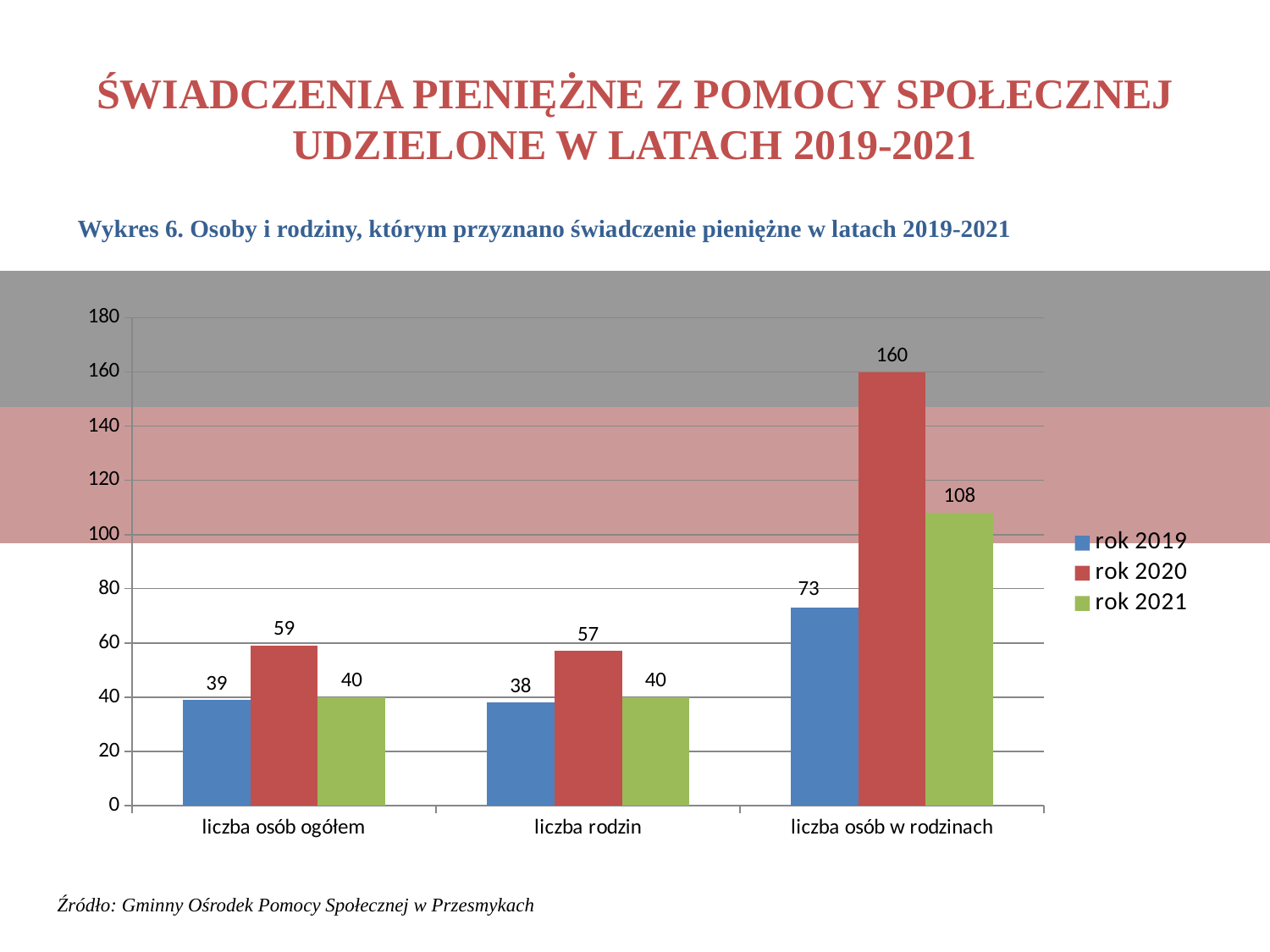
What is the value for 'rok 2020' in the 'liczba osób w rodzinach' category? 160 Which series has the highest value in the 'liczba osób w rodzinach' category? rok 2020 How many series does the legend list? 3 What is the value for 'rok 2019' in the 'liczba osób ogółem' category? 39 What is the value for 'rok 2021' in the 'liczba rodzin' category? 40 What kind of chart is shown on the slide? bar chart Which colour represents 'rok 2021' in the legend? green Which is larger: the 'rok 2020' value for 'liczba osób ogółem' or the 'rok 2020' value for 'liczba rodzin'? liczba osób ogółem What is the difference between the 'rok 2020' and 'rok 2021' values in the 'liczba osób w rodzinach' category? 52 How many categories are shown on the x axis? 3 Is the 'rok 2021' value for 'liczba osób w rodzinach' greater or less than 100? greater Which series has the lowest value in the 'liczba rodzin' category? rok 2019